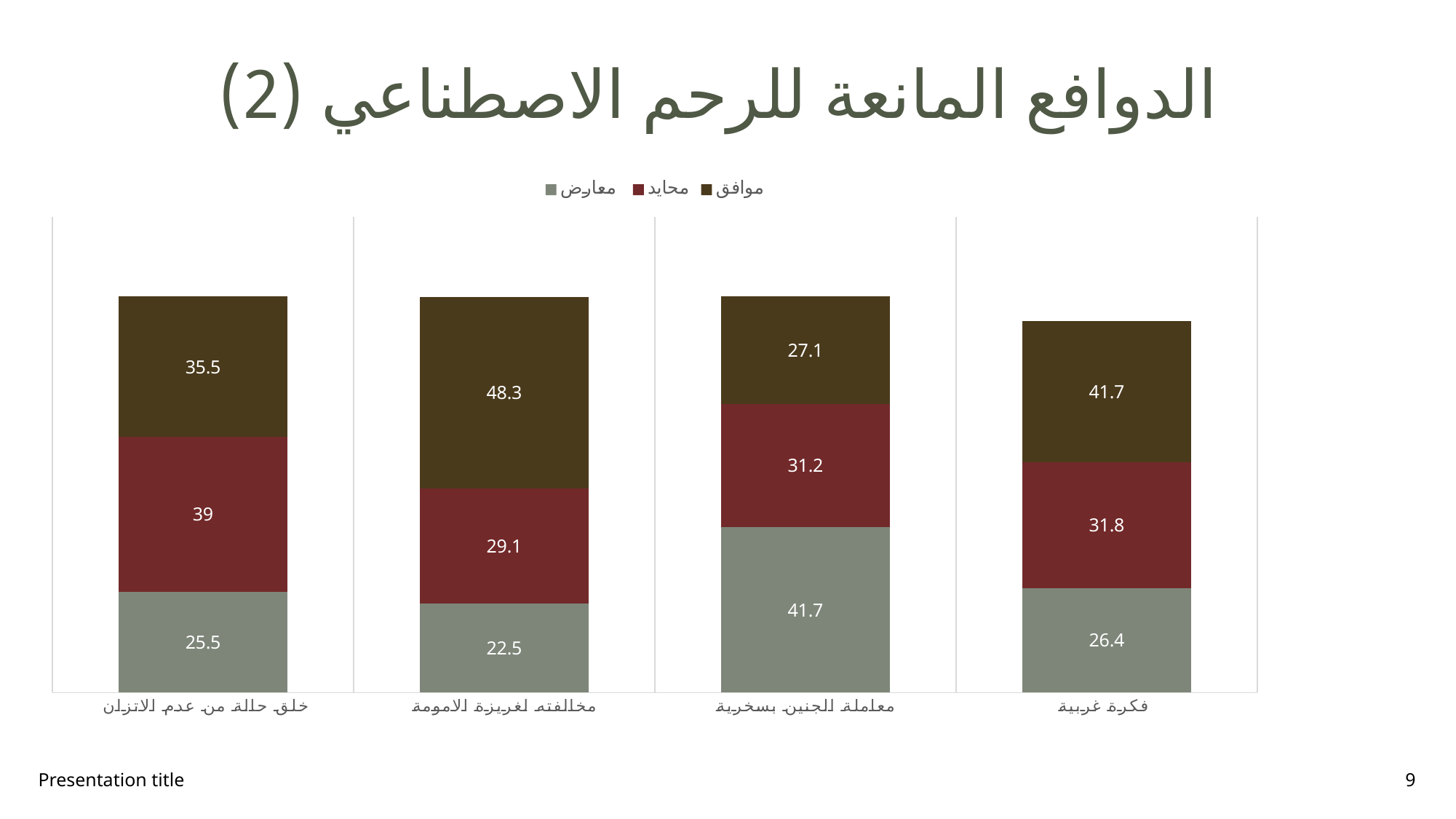
Which category has the lowest value for معارض? مخالفته لغريزة الامومة What is the total of the stacked bar for خلق حالة من عدم الاتزان? 100 What is the value of موافق for مخالفته لغريزة الامومة? 48.3 What is the value of معارض for معاملة الجنين بسخرية? 41.7 How many series does the legend list? 3 What kind of chart is shown on the slide? Stacked bar chart What is the value of موافق for فكرة غريبة? 41.7 How many categories are shown on the x axis? 4 What is the difference between the موافق value for مخالفته لغريزة الامومة and the موافق value for معاملة الجنين بسخرية? 21.2 What is the value of محايد for خلق حالة من عدم الاتزان? 39 Which category has the highest value for موافق? مخالفته لغريزة الامومة Which is larger: the محايد value for فكرة غريبة or the محايد value for معاملة الجنين بسخرية? فكرة غريبة